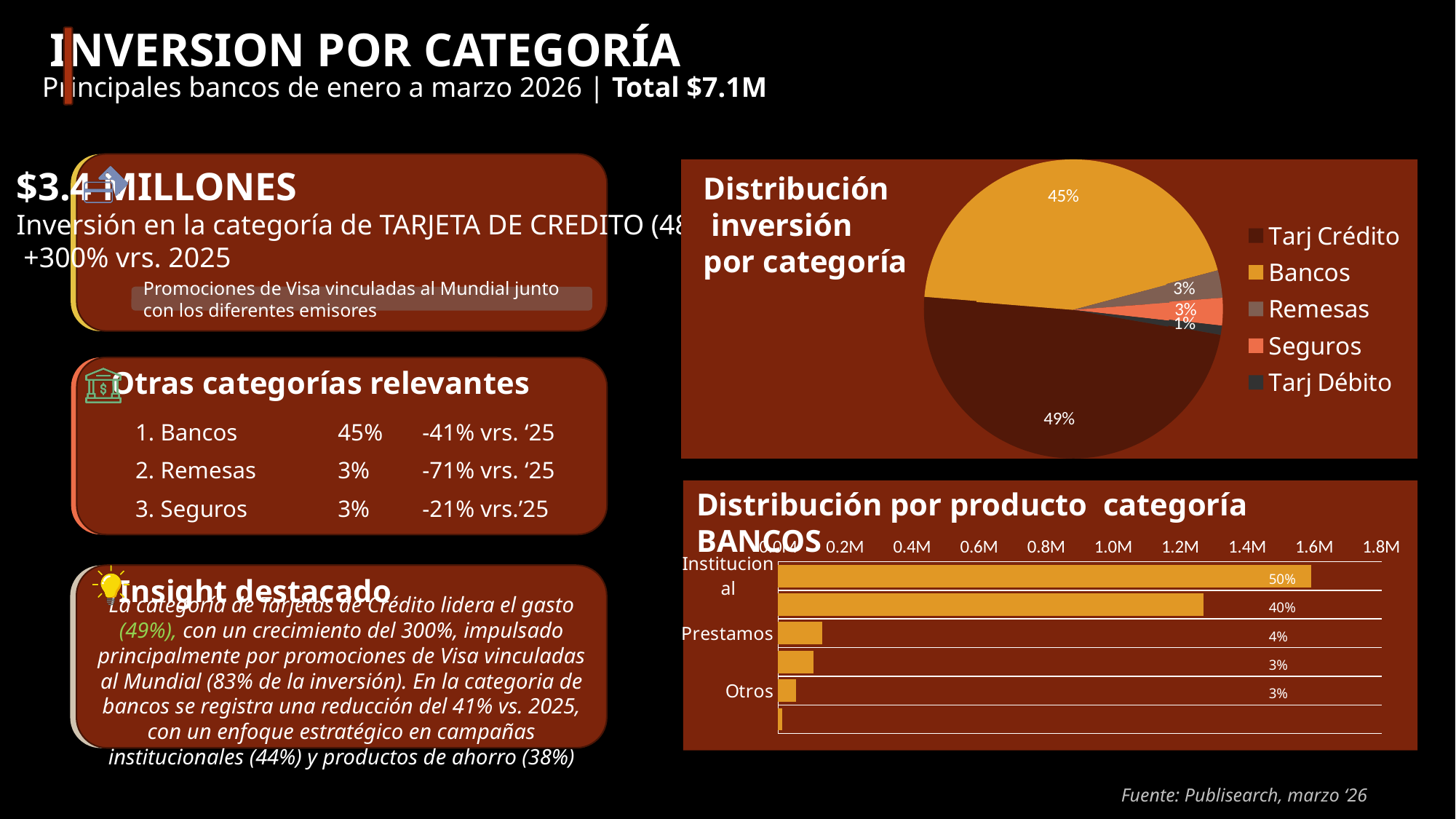
In the pie chart 'Distribución inversión por categoría', what share does Bancos have? 45% In the pie chart 'Distribución inversión por categoría', what is the difference in percentage points between Tarj Crédito and Bancos? 4 percentage points In the pie chart 'Distribución inversión por categoría', which category has the smallest share? Tarj Débito In the chart 'Distribución por producto categoría BANCOS', how many bars are plotted? 6 In the chart 'Distribución por producto categoría BANCOS', what percentage label is shown for Prestamos? 4% In the pie chart 'Distribución inversión por categoría', which category has the largest share? Tarj Crédito In the pie chart 'Distribución inversión por categoría', what share does Tarj Crédito have? 49% In the chart 'Distribución por producto categoría BANCOS', what percentage label is shown for Institucional? 50% In the pie chart 'Distribución inversión por categoría', how many categories does the legend list? 5 In the chart 'Distribución por producto categoría BANCOS', is the bar for Institucional greater or less than 1.4M? greater What kind of chart is 'Distribución por producto categoría BANCOS'? Bar chart In the pie chart 'Distribución inversión por categoría', what share does Tarj Débito have? 1%